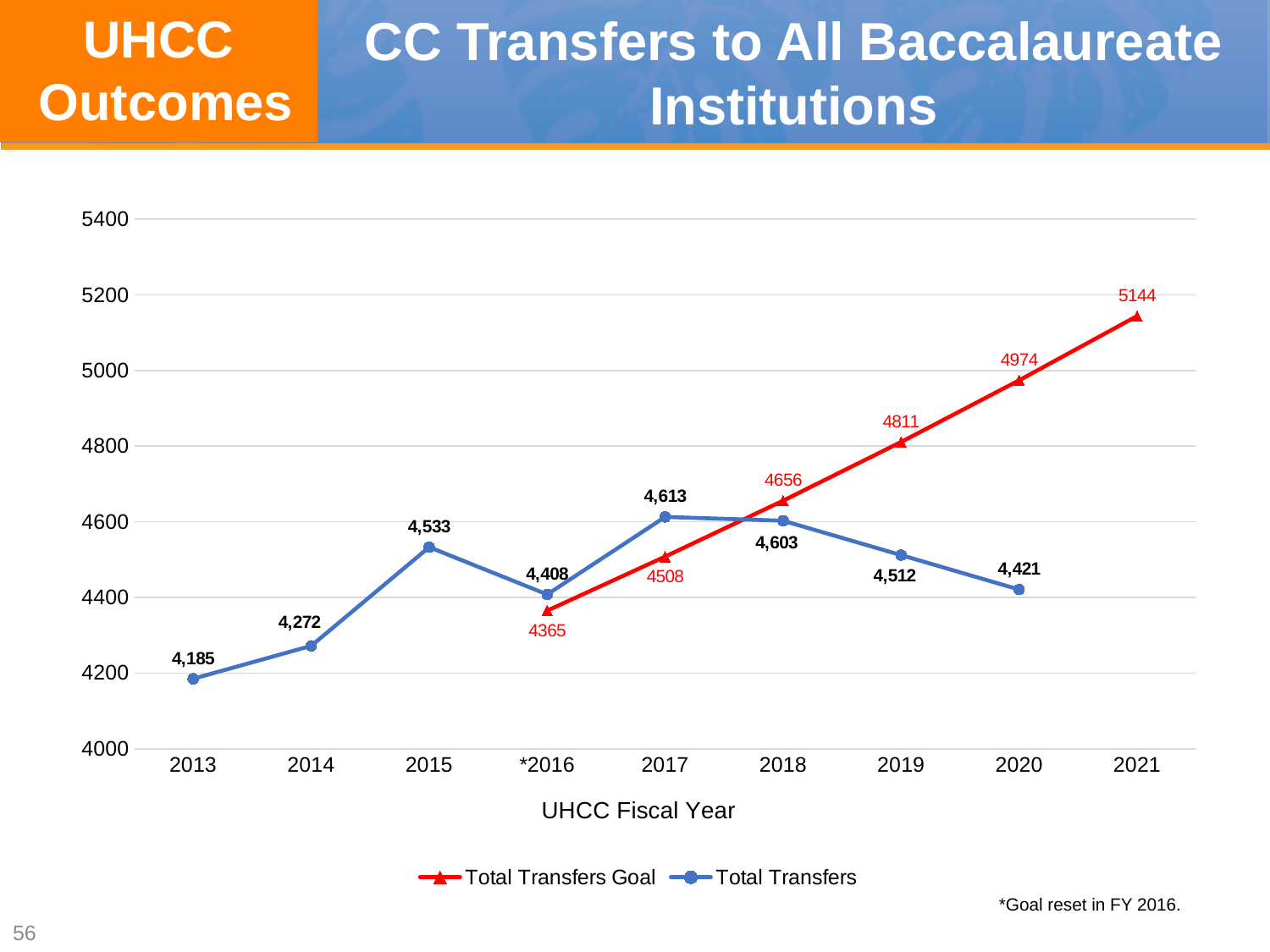
In which year is Total Transfers lowest? 2013 Does the Total Transfers Goal rise or fall from 2016 to 2021? Rise Is the Total Transfers Goal for 2019 greater or less than 4800? greater Which is larger in 2017, Total Transfers or the Total Transfers Goal? Total Transfers What is the value of Total Transfers in 2013? 4,185 What is the value of Total Transfers in 2015? 4,533 How many fiscal years are shown on the x axis? 9 What is the difference between the Total Transfers Goal and Total Transfers in 2020? 553 In which year is Total Transfers highest? 2017 What kind of chart is shown on the slide? Line chart What is the Total Transfers Goal for 2021? 5144 How many series does the legend list? 2